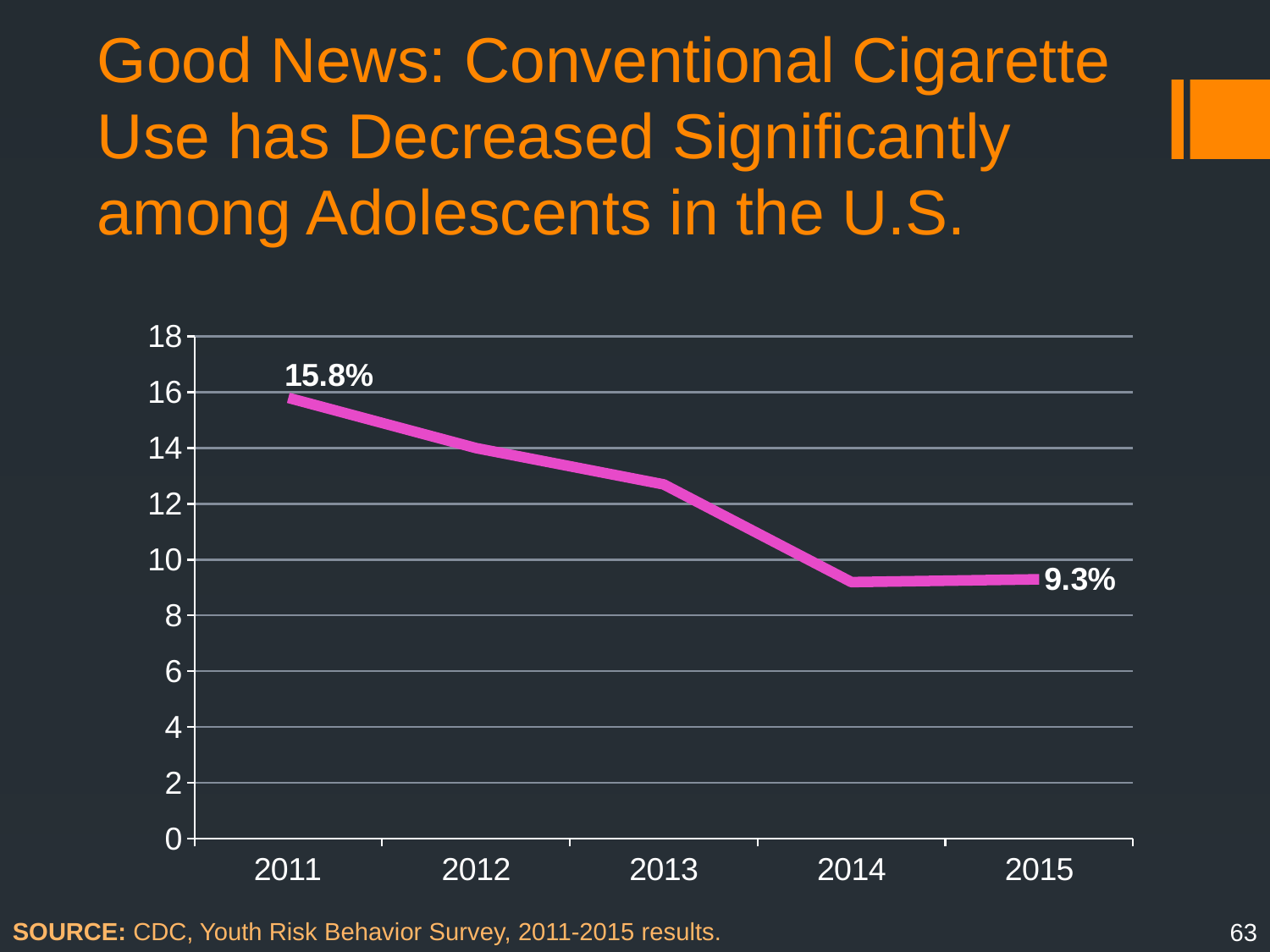
What is the value for 2015? 9.3% Do the values rise or fall from 2011 to 2015? fall Is the value for 2013 greater or less than 14? less What is the source cited for the chart data? CDC, Youth Risk Behavior Survey, 2011-2015 results. Which is larger, the value for 2011 or the value for 2015? 2011 How many years are plotted on the x axis? 5 What type of chart is shown on the slide? line chart Is the value for 2014 greater or less than 10? less Which year has the highest value? 2011 Is the value for 2012 greater or less than 12? greater What is the difference between the 2011 value and the 2015 value? 6.5 percentage points What is the value for 2011? 15.8%